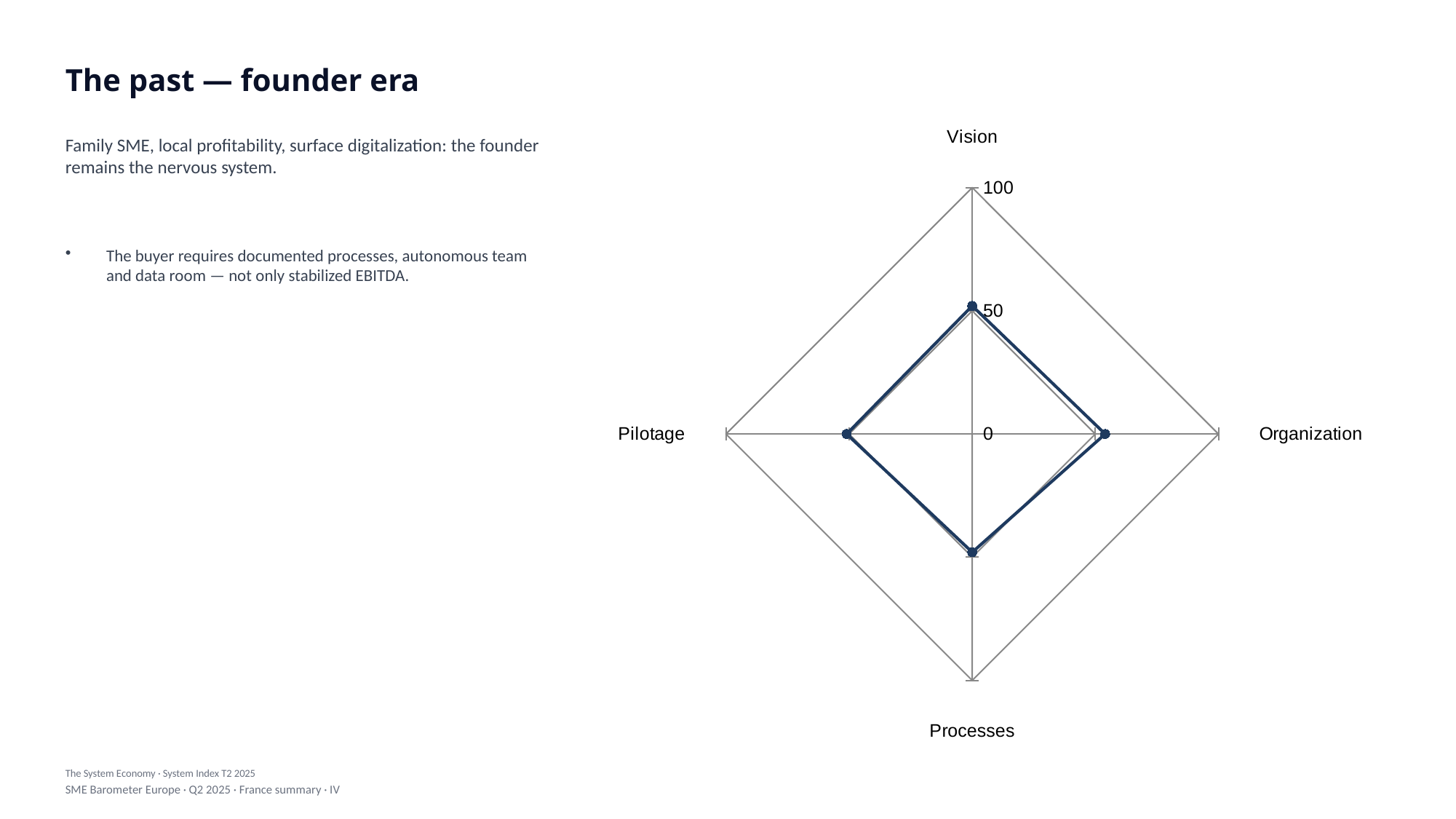
Which category label appears at the top of the radar chart? Vision Is the value for Pilotage greater or less than 100? less What is the maximum value shown on the radar chart's axis scale? 100 Is the value for Organization greater or less than 100? less Is the value for Processes greater or less than 100? less How many categories (axes) does the radar chart have? 4 What kind of chart is shown on the slide? radar chart